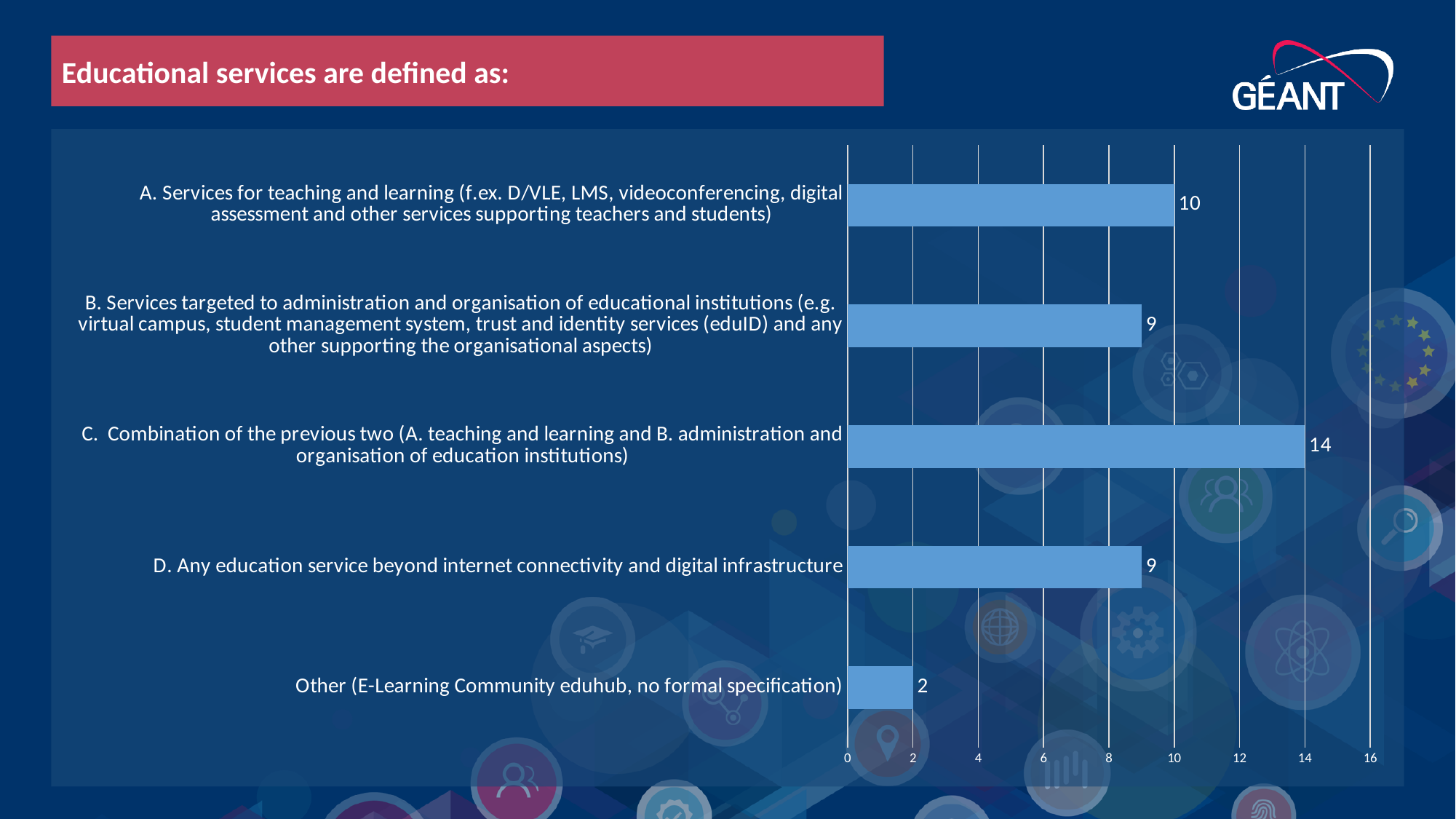
Which category has the lowest value? Other (E-Learning Community eduhub, no formal specification) Is the value for option C greater or less than 12? greater What is the value for option C (Combination of the previous two)? 14 What is the value for option D (Any education service beyond internet connectivity and digital infrastructure)? 9 Which is larger, the value for option A or the value for option B? A. Services for teaching and learning What is the difference between the values for option C and option A? 4 Which category has the highest value? C. Combination of the previous two What is the value for option A (Services for teaching and learning)? 10 What is the value for 'Other (E-Learning Community eduhub, no formal specification)'? 2 What kind of chart is shown on the slide? Bar chart How many categories are shown in the chart? 5 What is the title shown in the red banner above the chart? Educational services are defined as: